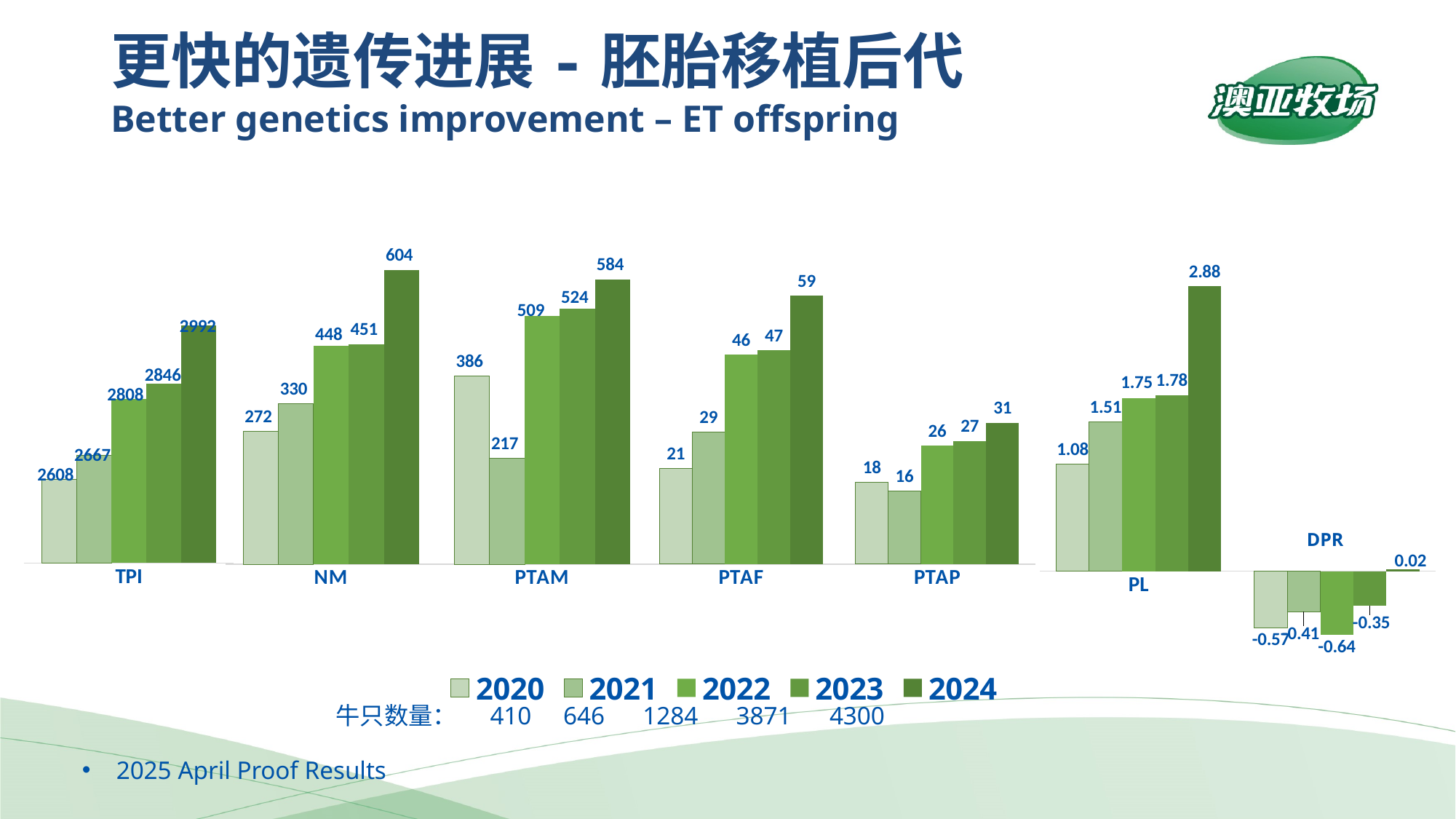
Which year has the highest value for PTAF? 2024 What is the 2021 value for PTAM? 217 What is the difference between the 2024 and 2020 values for TPI? 384 For PTAM, which is larger, the 2020 value or the 2021 value? 2020 Which year has the lowest value for PTAP? 2021 What is the difference between the 2024 and 2023 values for NM? 153 What is the 2020 value for TPI? 2608 What kind of chart is shown on the slide? Bar chart How many series does the legend list? 5 What is the 2024 value for NM? 604 Do the NM values rise or fall from 2020 to 2024? Rise What is the 2024 value for DPR? 0.02